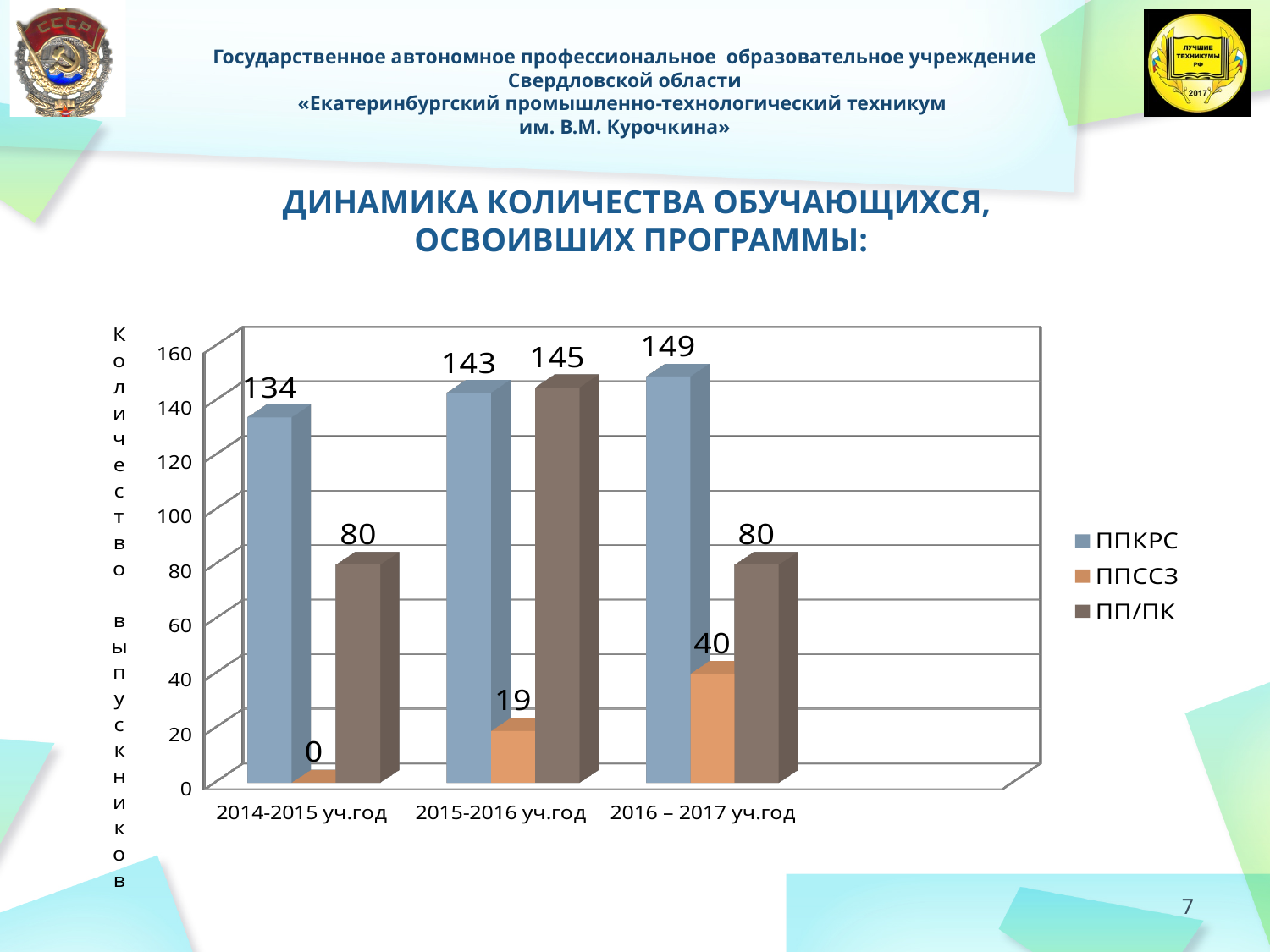
What is the difference between the ППКРС values for 2016 – 2017 уч.год and 2014-2015 уч.год? 15 What is the value for ППССЗ in 2014-2015 уч.год? 0 What is the value for ПП/ПК in 2015-2016 уч.год? 145 How many academic years are shown on the x axis? 3 What kind of chart is shown on the slide? bar chart What is the value for ППССЗ in 2016 – 2017 уч.год? 40 In which academic year is the ППКРС value highest? 2016 – 2017 уч.год What is the value for ППКРС in 2014-2015 уч.год? 134 Do the ППКРС values rise or fall from 2014-2015 уч.год to 2016 – 2017 уч.год? rise In which academic year is the ППССЗ value lowest? 2014-2015 уч.год How many series does the legend list? 3 Which is larger in 2015-2016 уч.год: ППКРС or ПП/ПК? ПП/ПК